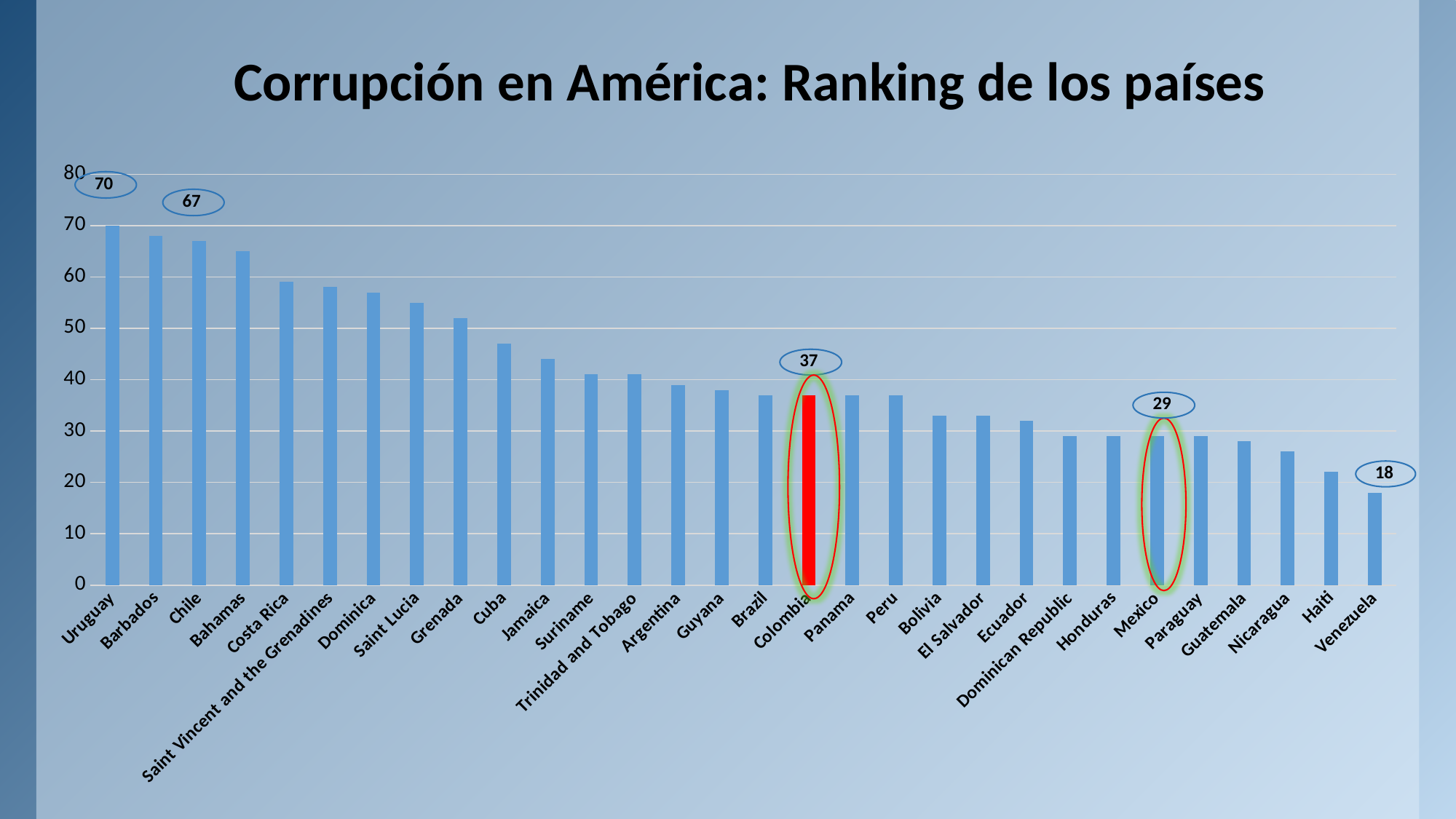
Is the value for Costa Rica greater or less than 50? greater Which is larger, the value for Colombia or the value for Mexico? Colombia Which country's bar is coloured red? Colombia How many countries are shown on the chart? 30 What is the value for Colombia? 37 What is the value for Uruguay? 70 What is the difference between the values for Uruguay and Venezuela? 52 What kind of chart is shown on the slide? bar chart Which country has the highest value? Uruguay What is the value for Venezuela? 18 Which country has the lowest value? Venezuela What is the value for Mexico? 29